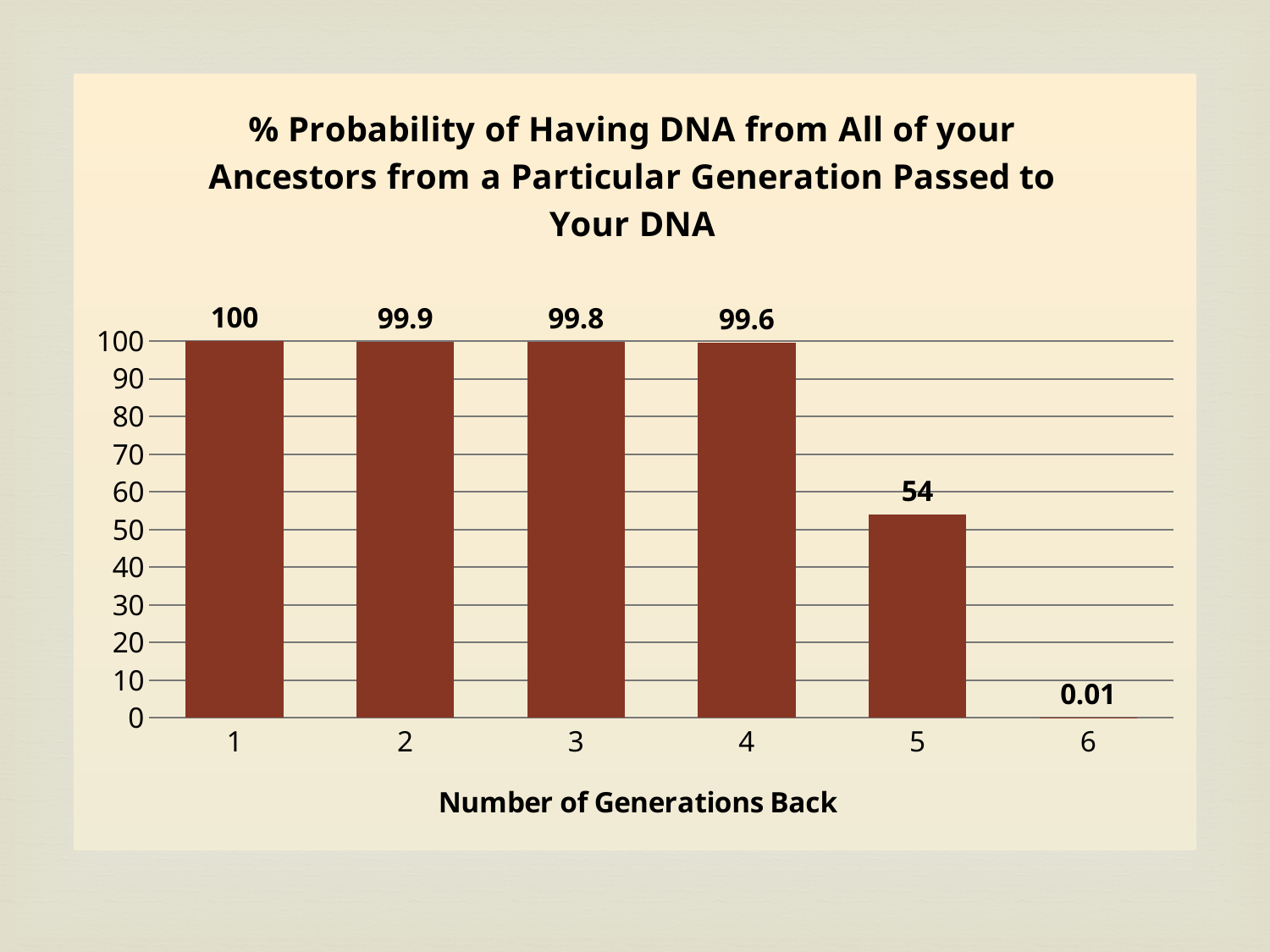
Which is larger, the value for 3 generations back or 5 generations back? 3 generations back What is the difference between the values for 1 and 2 generations back? 0.1 How many categories are shown on the x axis? 6 Which number of generations back has the lowest value? 6 What is the value for 4 generations back? 99.6 What is the value for 5 generations back? 54 What is the value for 1 generation back? 100 What kind of chart is this? Bar chart Do the values rise or fall as the number of generations back increases? Fall What is the value for 6 generations back? 0.01 Which number of generations back has the highest value? 1 What is the difference between the values for 4 and 5 generations back? 45.6